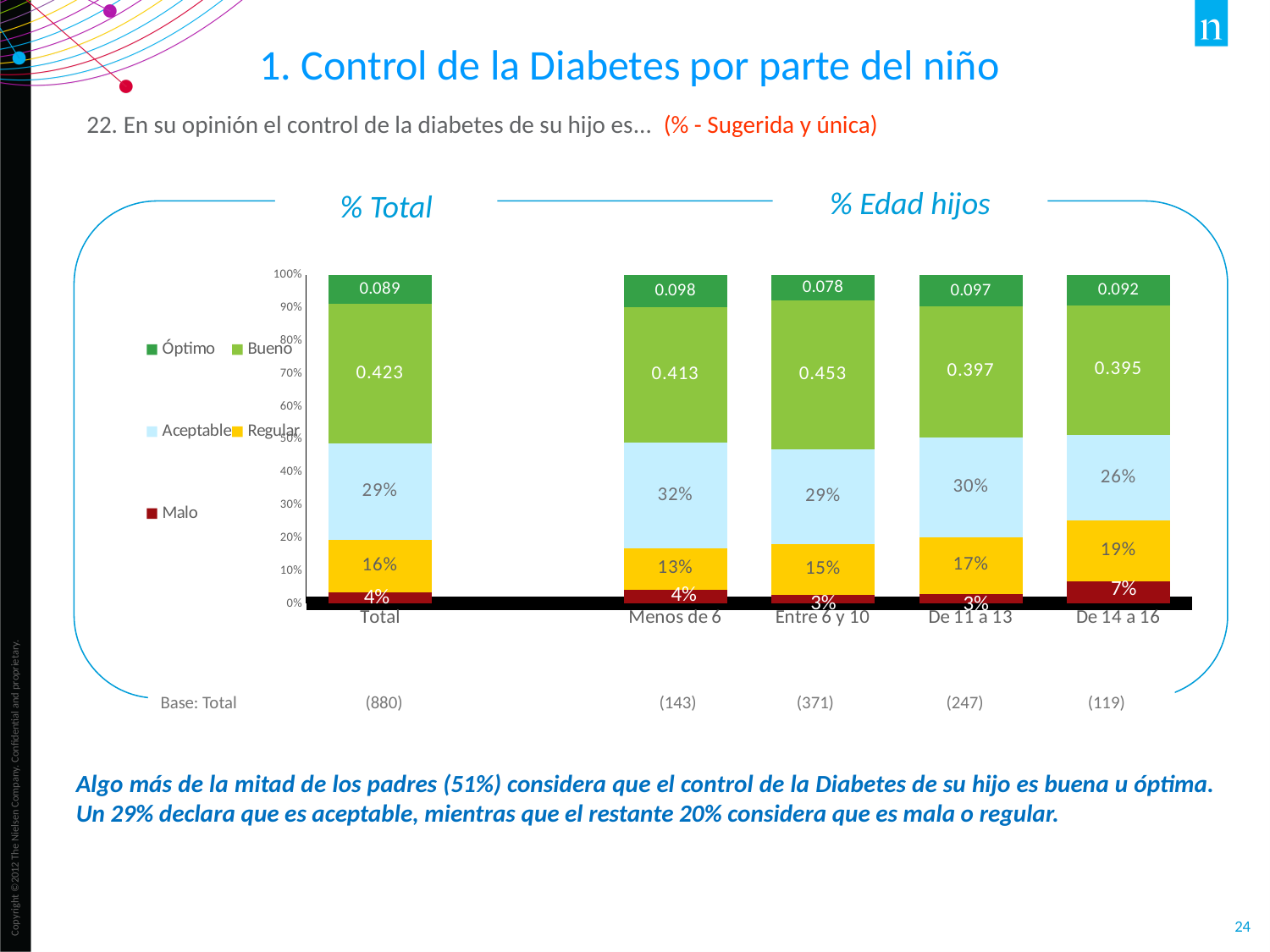
What is the Aceptable value for the Menos de 6 category? 32% What kind of chart is shown on the slide? Stacked bar chart How many series does the legend list? 5 Which has a larger Aceptable value, Menos de 6 or De 11 a 13? Menos de 6 Which category has the highest Bueno value? Entre 6 y 10 What is the difference between the Regular value for De 14 a 16 and the Regular value for Menos de 6? 6% How many categories are shown on the x axis of the chart? 5 What is the Regular value for the De 14 a 16 category? 19% What is the value of the Óptimo segment for the Entre 6 y 10 bar? 0.078 Which category has the lowest Aceptable value? De 14 a 16 What is the value of the Bueno segment for the Total bar? 0.423 What is the Malo value for the De 14 a 16 category? 7%